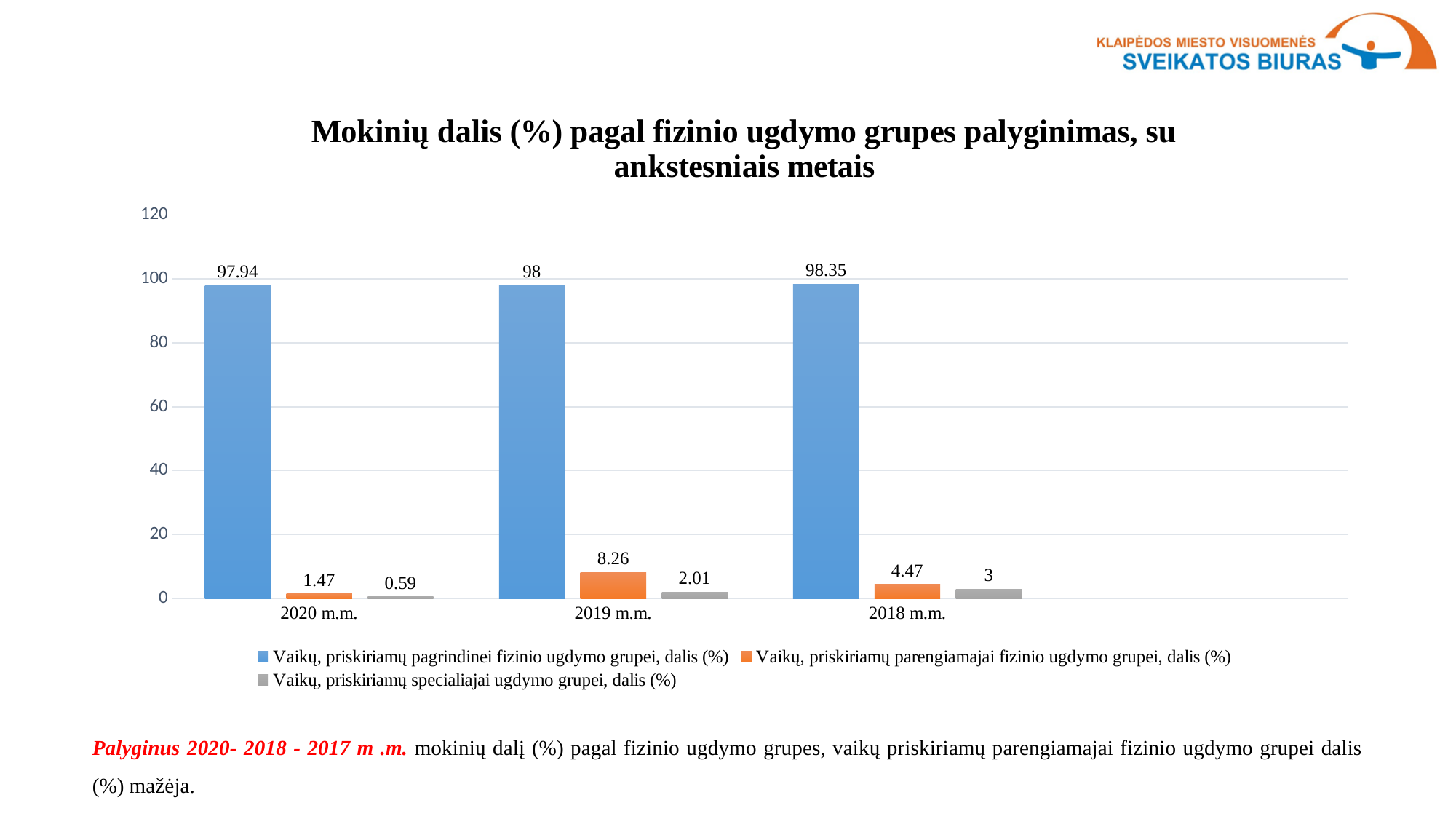
What is the value for the main physical education group (pagrindinei fizinio ugdymo grupei) in 2020 m.m.? 97.94 What is the value for the preparatory physical education group (parengiamajai fizinio ugdymo grupei) in 2019 m.m.? 8.26 What is the difference between the preparatory group values in 2019 m.m. and 2020 m.m.? 6.79 Is the value for the main physical education group in 2018 m.m. greater or less than 80? greater What colour are the bars for the main physical education group (pagrindinei fizinio ugdymo grupei)? Blue How many categories (school years) are shown on the x axis? 3 How many series does the legend list? 3 What kind of chart is shown on the slide? Bar chart What is the value for the special education group (specialiajai ugdymo grupei) in 2018 m.m.? 3 In which school year is the value for the special education group the lowest? 2020 m.m. In which school year is the value for the preparatory physical education group the highest? 2019 m.m. Which is larger: the special education group value in 2019 m.m. or in 2018 m.m.? 2018 m.m.